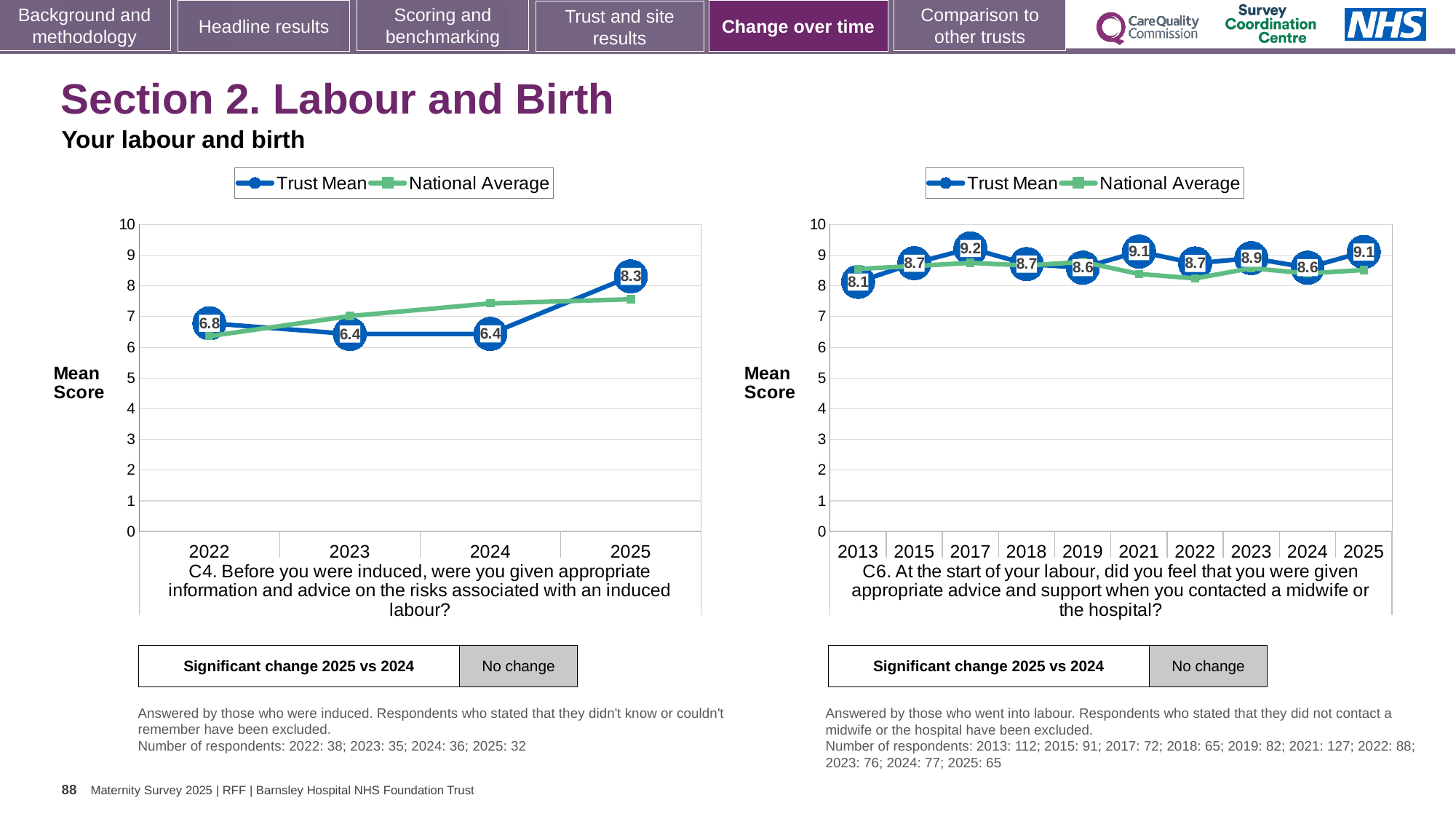
In the left chart (C4), is the National Average for 2025 greater or less than 7? greater In the right chart (C6), which year has the lowest Trust Mean score? 2013 What type of chart is used on the left (C4)? Line chart In the right chart (C6), what is the Trust Mean score for 2017? 9.2 In the right chart (C6), is the Trust Mean score for 2021 larger than the score for 2024? Yes, 2021 (9.1) is larger than 2024 (8.6) In the left chart (C4), what is the difference between the Trust Mean scores for 2025 and 2024? 1.9 In the left chart (C4), which year has the highest Trust Mean score? 2025 In the left chart (C4), what is the Trust Mean score for 2025? 8.3 How many series does the legend of the right chart (C6) list? 2 In the left chart (C4), how many years are shown on the x axis? 4 In the left chart (C4), what is the Trust Mean score for 2022? 6.8 In the right chart (C6), how many years are shown on the x axis? 10